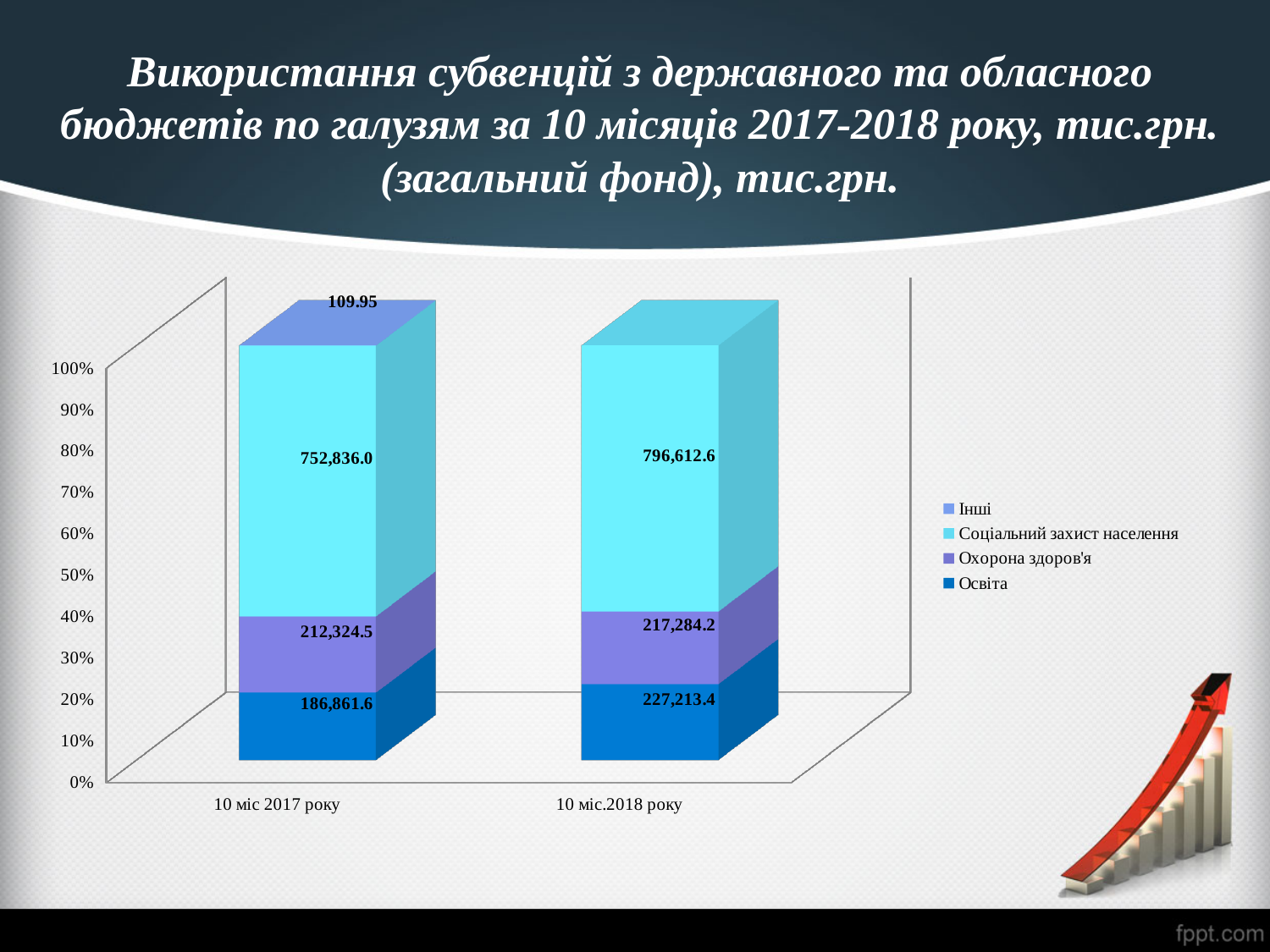
What is the difference between the Освіта values for 10 міс.2018 року and 10 міс 2017 року? 40,351.8 Which series has the smallest value in 10 міс 2017 року? Інші Which is larger: Охорона здоров'я in 10 міс 2017 року or Освіта in 10 міс 2017 року? Охорона здоров'я in 10 міс 2017 року What kind of chart is shown on the slide? Stacked bar chart What is the value for Інші in 10 міс 2017 року? 109.95 How many categories are shown on the x axis? 2 How many series does the legend list? 4 What is the value for Соціальний захист населення in 10 міс.2018 року? 796,612.6 What is the value for Освіта in 10 міс 2017 року? 186,861.6 Which series has the largest value in 10 міс 2017 року? Соціальний захист населення What is the value for Охорона здоров'я in 10 міс 2017 року? 212,324.5 What is the difference between the Соціальний захист населення values for 10 міс.2018 року and 10 міс 2017 року? 43,776.6